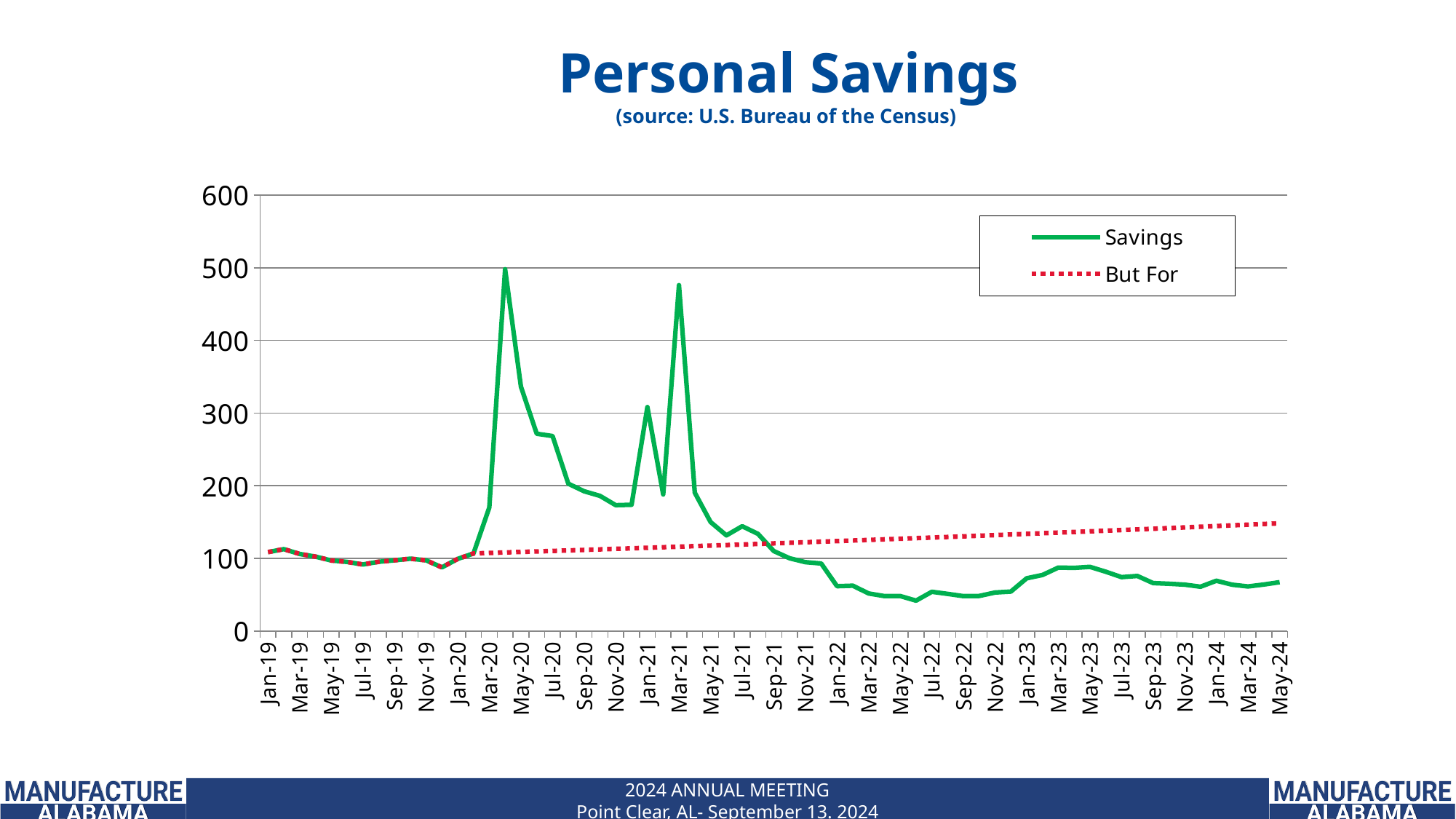
What kind of chart is shown on the slide? line chart Is the But For value at May-24 greater or less than 200? less What are the two series named in the legend? Savings and But For At May-24, which series has the higher value, Savings or But For? But For Does the But For line rise or fall from Jan-20 to May-24? rise Is the Savings value at May-22 greater or less than 100? less Which series reaches the highest value on the chart? Savings In which year does the Savings line reach its highest point? 2020 Is the peak value of the Savings line in 2020 greater or less than 400? greater What is the title of the chart? Personal Savings How many series does the legend list? 2